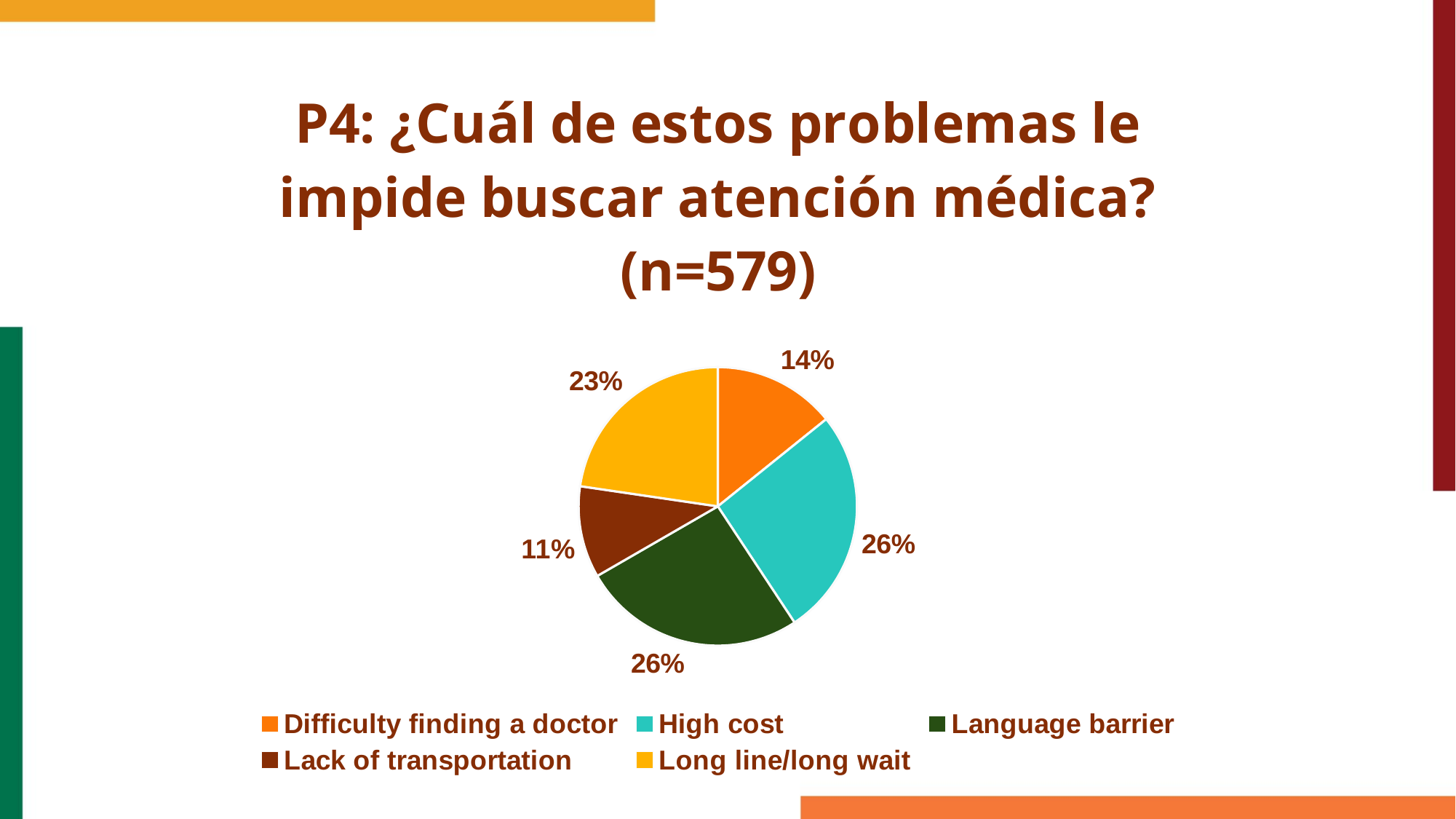
How many categories does the pie chart have? 5 Which category has the smallest slice of the pie? Lack of transportation What percentage is shown for Long line/long wait? 23% What percentage is shown for Language barrier? 26% What is the sample size (n) given in the chart title? 579 What is the difference in percentage points between Long line/long wait and Difficulty finding a doctor? 9 What percentage is shown for Difficulty finding a doctor? 14% What kind of chart is shown on the slide? pie chart What share of the pie does Lack of transportation represent? 11% Which is larger, the slice for Long line/long wait or the slice for Difficulty finding a doctor? Long line/long wait What percentage of the pie is labelled for High cost? 26% What percentage is shown for Lack of transportation? 11%